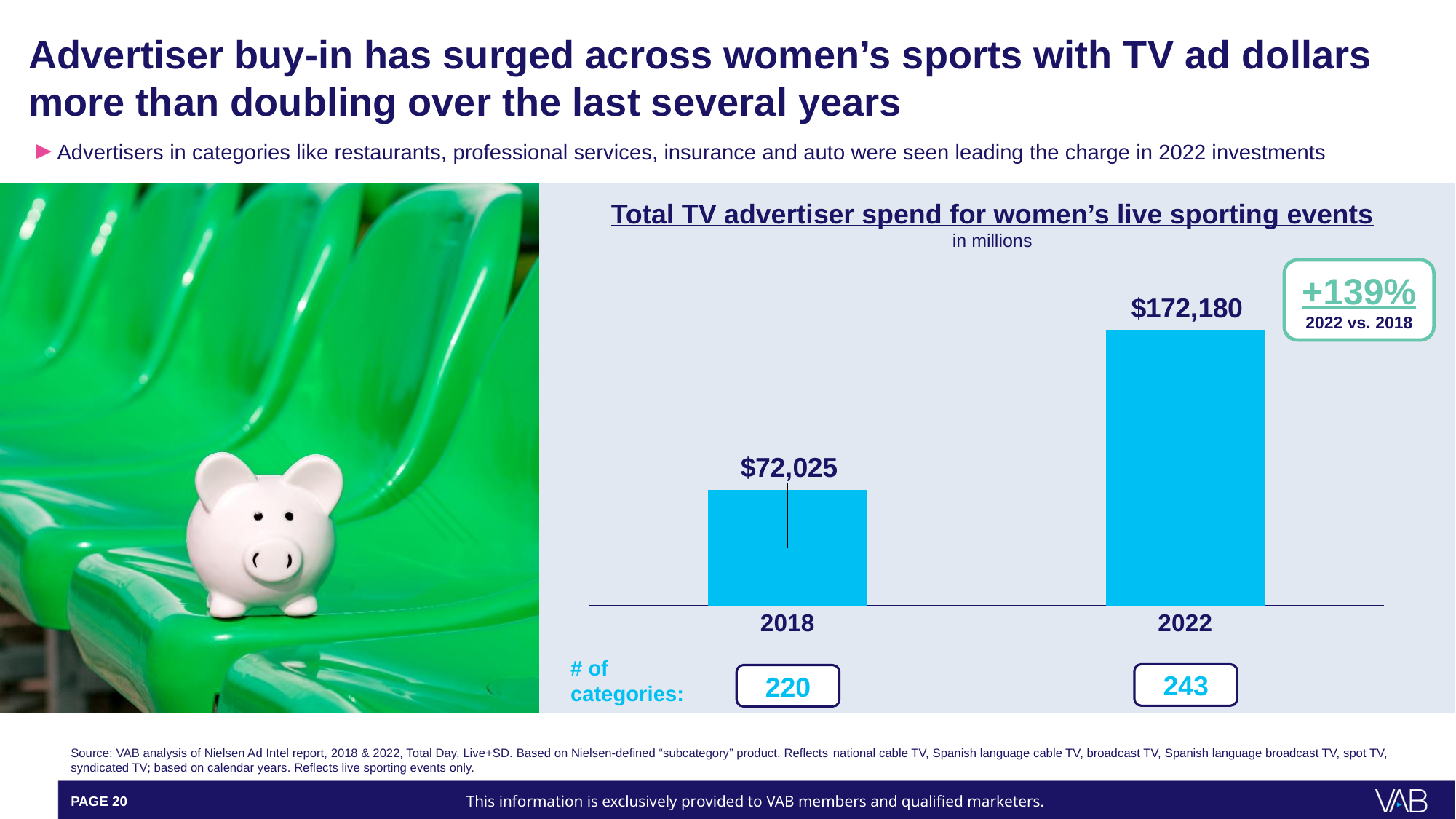
Is the total TV advertiser spend larger in 2018 or in 2022? 2022 Which year has the higher total TV advertiser spend for women's live sporting events? 2022 What is the difference in total TV advertiser spend between 2022 and 2018? $100,155 What percentage change in spend is shown for 2022 vs. 2018? +139% In what units are the chart values expressed? in millions How many advertiser categories are shown for 2022? 243 Which year has the lower total TV advertiser spend for women's live sporting events? 2018 What is the total TV advertiser spend for women's live sporting events in 2022? $172,180 Does the total TV advertiser spend rise or fall from 2018 to 2022? Rise What kind of chart is used to show total TV advertiser spend for women's live sporting events? Bar chart How many years are shown in the chart? 2 What is the total TV advertiser spend for women's live sporting events in 2018? $72,025